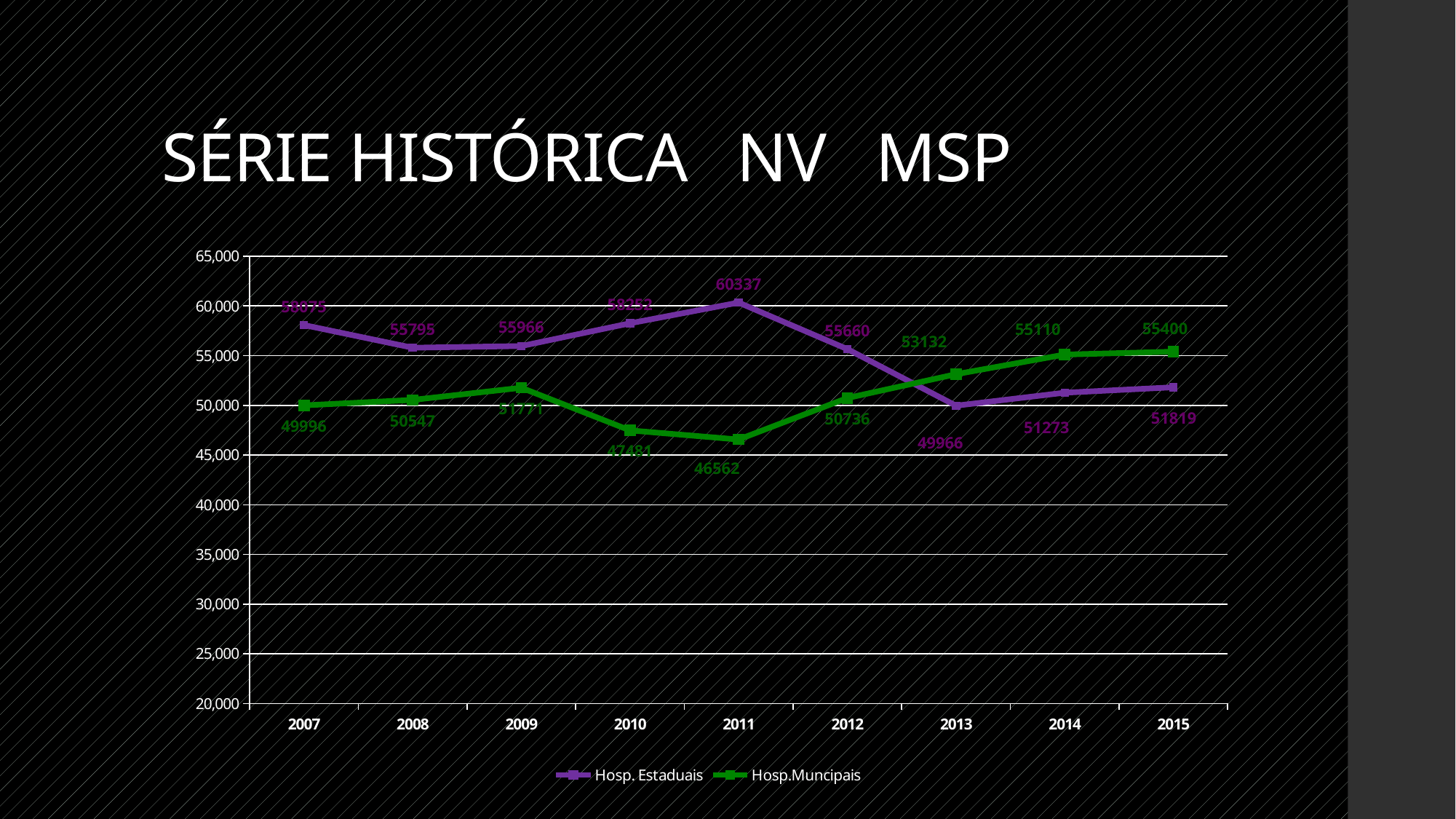
What kind of chart is shown on the slide? line chart Is the value for Hosp. Estaduais in 2007 greater or less than 55,000? greater What is the value for Hosp.Muncipais in 2015? 55400 What is the difference between Hosp.Muncipais and Hosp. Estaduais in 2013? 3166 In which year does Hosp.Muncipais reach its lowest value? 2011 What is the value for Hosp. Estaduais in 2013? 49966 What is the value for Hosp. Estaduais in 2011? 60337 How many series does the legend list? 2 In which year does Hosp. Estaduais reach its highest value? 2011 What is the difference between Hosp.Muncipais and Hosp. Estaduais in 2015? 3581 In 2012, which series has the larger value, Hosp. Estaduais or Hosp.Muncipais? Hosp. Estaduais How many years are shown on the x axis? 9